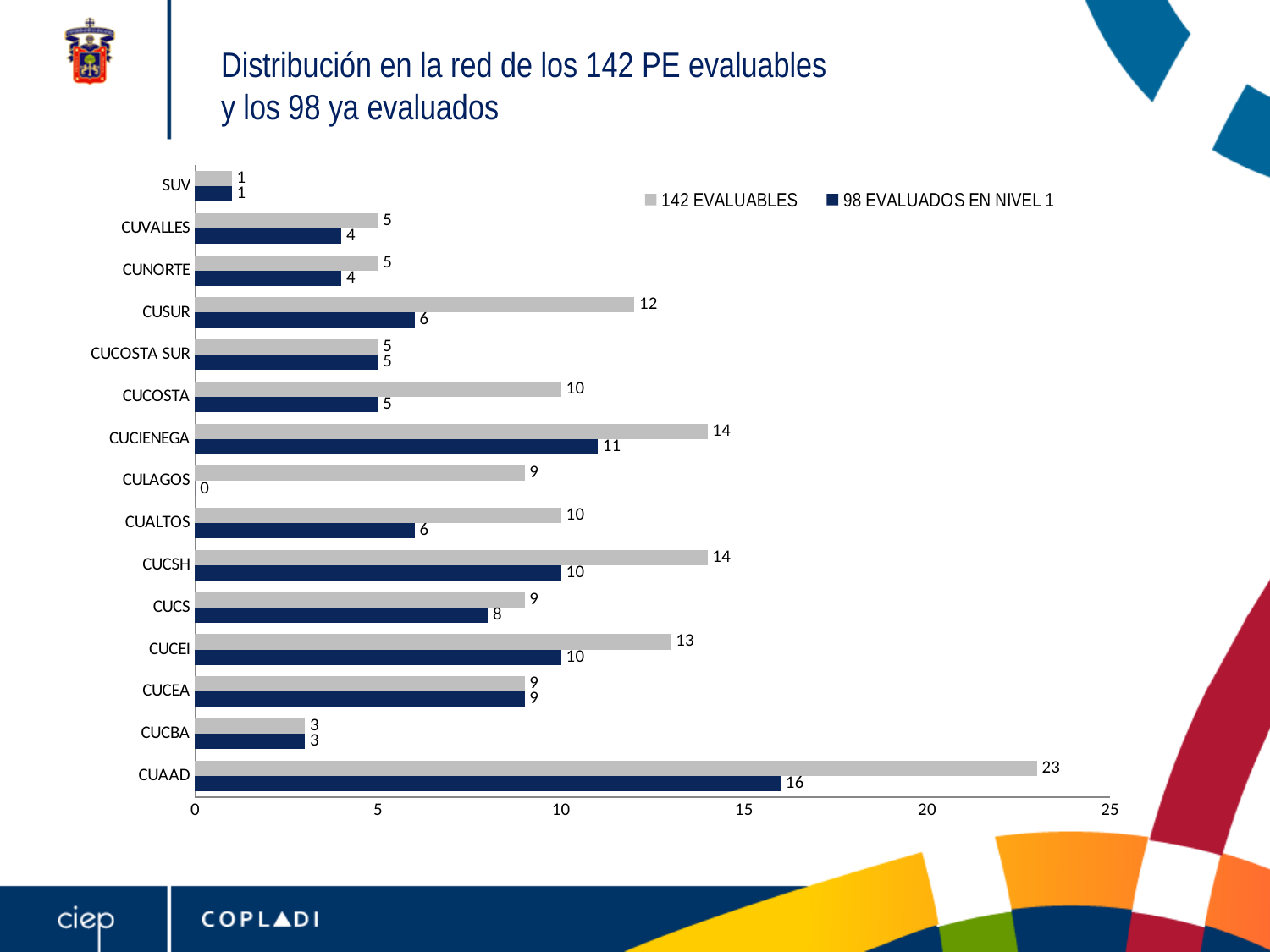
Which category has the lowest value for 98 EVALUADOS EN NIVEL 1? CULAGOS Which colour represents the 98 EVALUADOS EN NIVEL 1 series? dark blue What is the value of 142 EVALUABLES for CUAAD? 23 How many series does the legend list? 2 What is the value of 98 EVALUADOS EN NIVEL 1 for CULAGOS? 0 Is the 142 EVALUABLES value for CUAAD greater or less than 20? greater Which is larger for CUCEI: the 142 EVALUABLES value or the 98 EVALUADOS EN NIVEL 1 value? 142 EVALUABLES What is the value of 98 EVALUADOS EN NIVEL 1 for CUCIENEGA? 11 Which category has the highest value for 142 EVALUABLES? CUAAD What kind of chart is shown on the slide? bar chart How many categories are shown on the chart? 15 What is the difference between the 142 EVALUABLES value and the 98 EVALUADOS EN NIVEL 1 value for CUSUR? 6